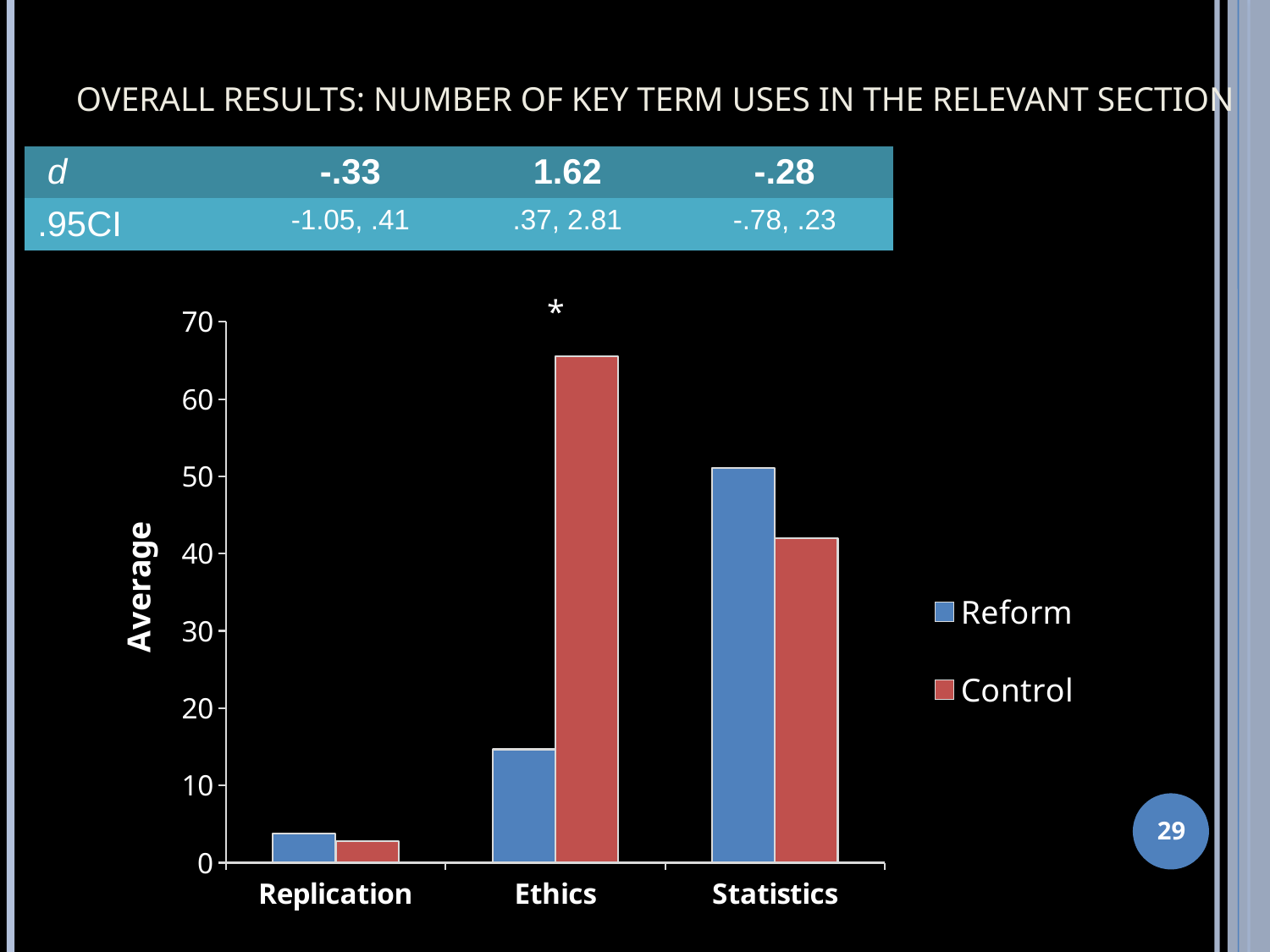
Is the Control value for Statistics greater or less than 50? less For Statistics, which is larger: Reform or Control? Reform For the Control series, which category has the lowest bar? Replication Is the Control value for Ethics greater or less than 60? greater What is the title of the chart's y axis? Average Is the Reform value for Ethics greater or less than 20? less How many series does the chart's legend list? 2 Which category and series has the tallest bar in the chart? Control for Ethics How many categories are shown on the x axis of the chart? 3 What kind of chart is shown on the slide? bar chart For Ethics, which is larger: Reform or Control? Control